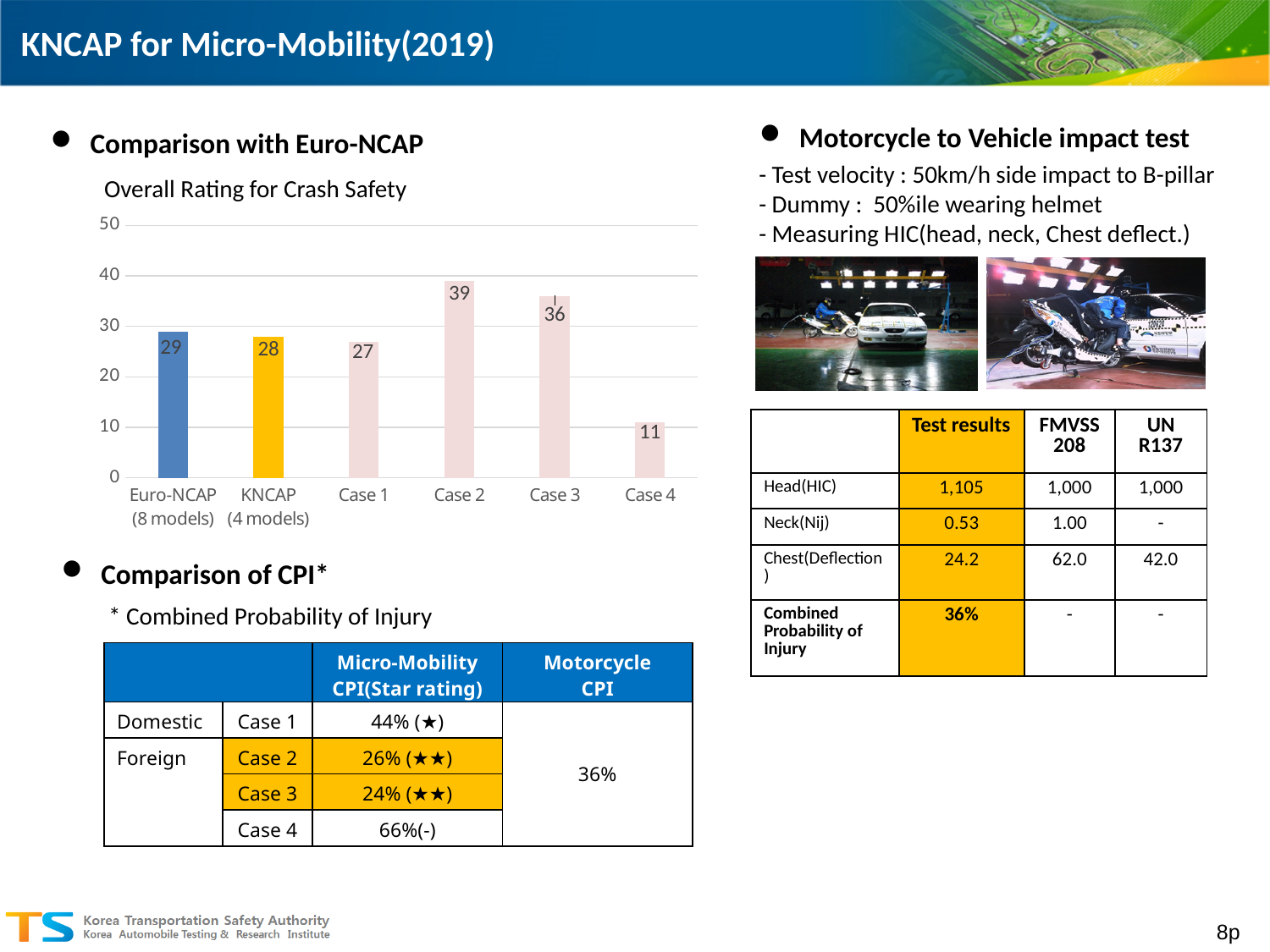
What is the value for Euro-NCAP (8 models) in the Overall Rating for Crash Safety chart? 29 In the Overall Rating for Crash Safety chart, which is larger, the value for Case 1 or the value for Case 3? Case 3 What type of chart is the Overall Rating for Crash Safety chart? bar chart What is the value for Case 2 in the Overall Rating for Crash Safety chart? 39 What is the difference between the values for Case 2 and Case 3 in the Overall Rating for Crash Safety chart? 3 What is the value for KNCAP (4 models) in the Overall Rating for Crash Safety chart? 28 What is the difference between the values for Euro-NCAP (8 models) and Case 4 in the Overall Rating for Crash Safety chart? 18 How many categories are shown in the Overall Rating for Crash Safety chart? 6 What is the value for Case 4 in the Overall Rating for Crash Safety chart? 11 Which category has the highest value in the Overall Rating for Crash Safety chart? Case 2 Which category has the lowest value in the Overall Rating for Crash Safety chart? Case 4 Is the value for Case 3 in the Overall Rating for Crash Safety chart greater or less than 30? greater